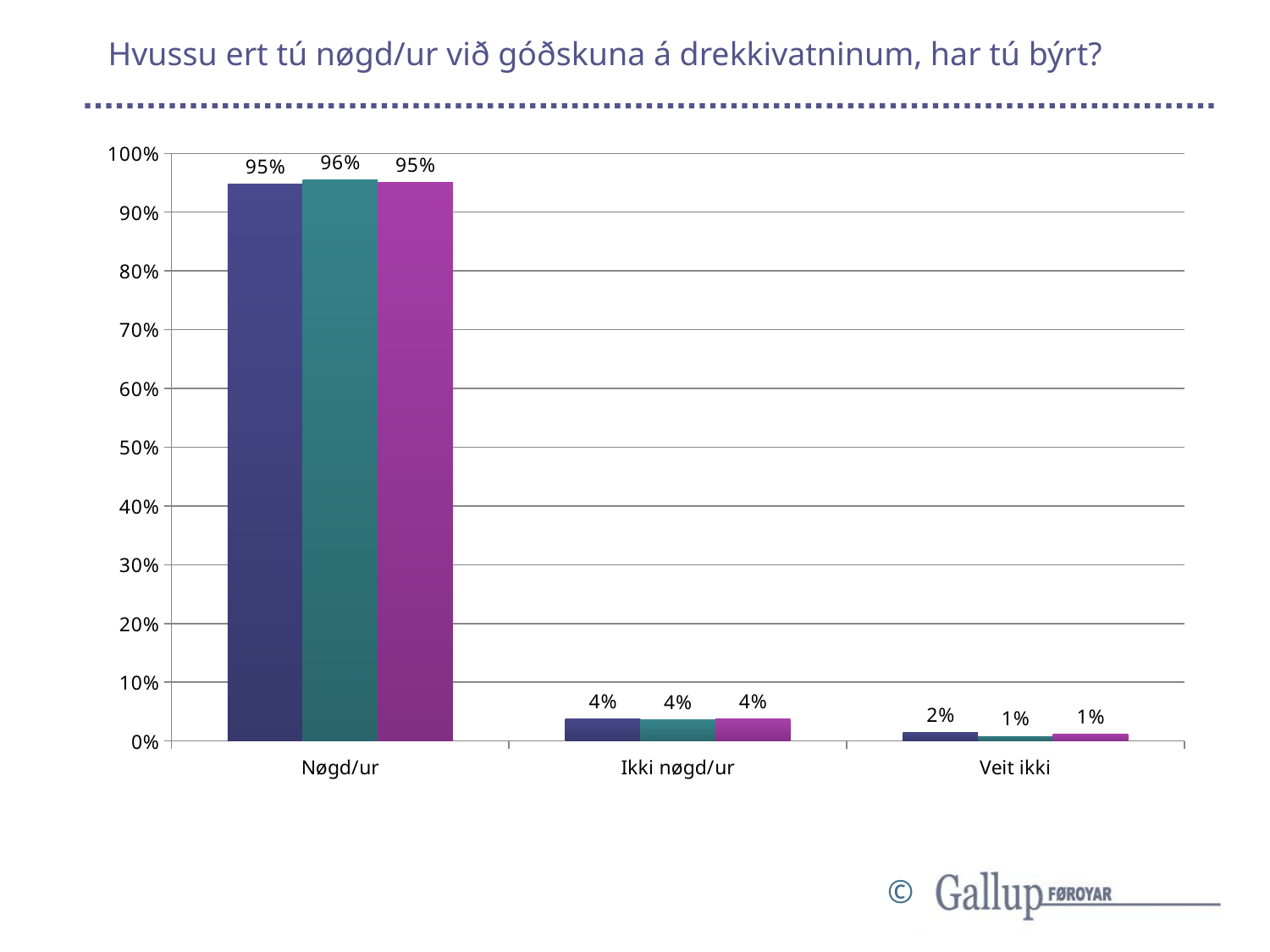
How many bars are plotted for each category? 3 How many categories are shown on the x axis of the chart? 3 What kind of chart is shown on the slide? bar chart Are the values for Nøgd/ur greater or less than 90%? greater Which category has the highest values? Nøgd/ur What is the value of the magenta (right) bar for Ikki nøgd/ur? 4% For the dark purple (left) bars, which is larger: Ikki nøgd/ur or Veit ikki? Ikki nøgd/ur What is the value of the teal (middle) bar for Nøgd/ur? 96% What is the difference between the teal bar for Nøgd/ur and the teal bar for Ikki nøgd/ur? 92% Which category has the lowest values? Veit ikki What is the value of the dark purple (left) bar for Veit ikki? 2% What is the title of the chart? Hvussu ert tú nøgd/ur við góðskuna á drekkivatninum, har tú býrt?